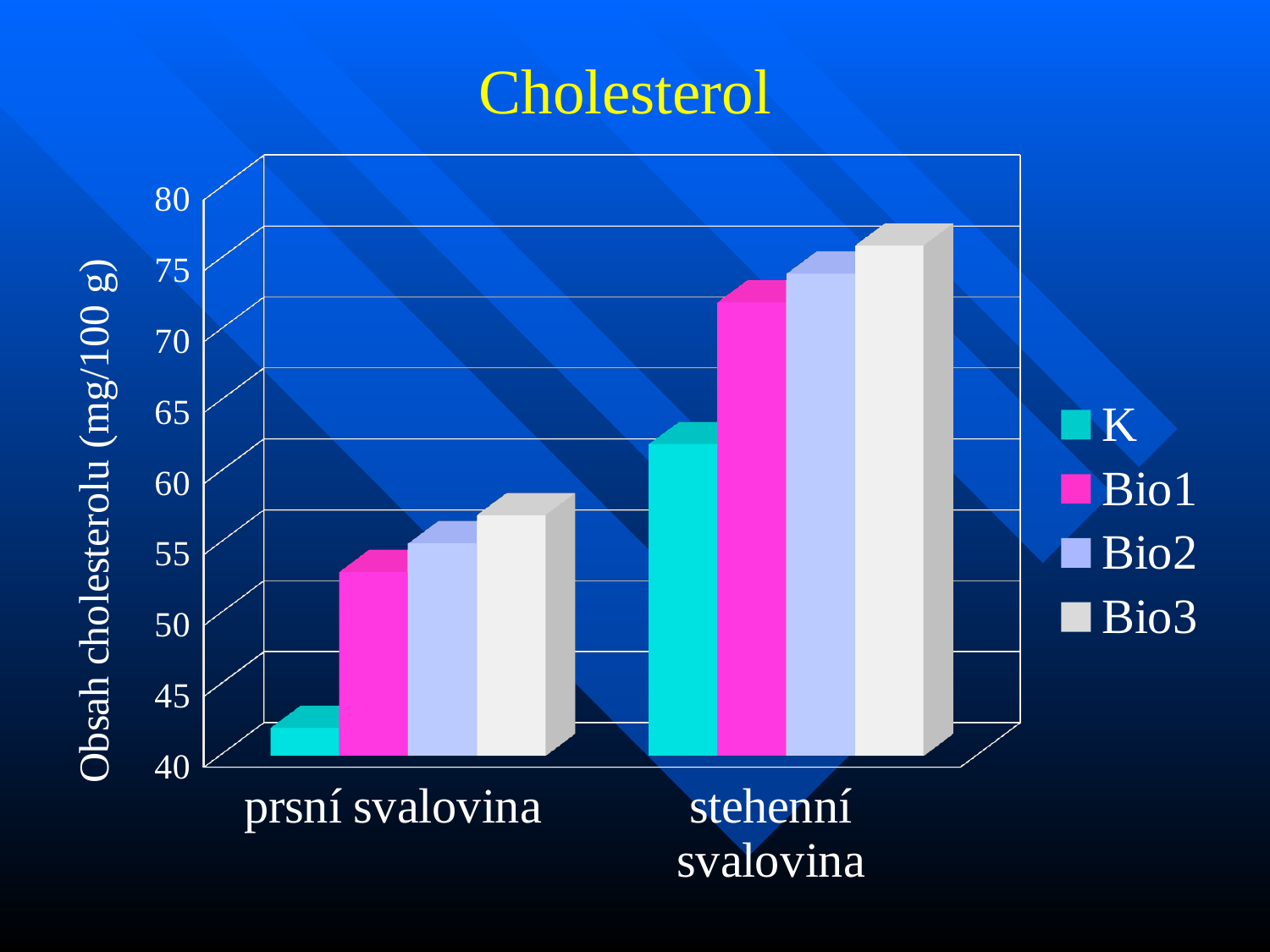
Which is larger: the value for K in prsní svalovina or the value for K in stehenní svalovina? stehenní svalovina Which series has the lowest value for prsní svalovina? K How many series does the legend list? 4 What is the label of the vertical axis? Obsah cholesterolu (mg/100 g) Is the value for Bio1 in stehenní svalovina greater or less than 70? greater Is the value for K in prsní svalovina greater or less than 45? less Is the value for Bio1 in prsní svalovina greater or less than 50? greater What is the title of the chart? Cholesterol Which series has the highest value for stehenní svalovina? Bio3 How many categories are shown on the x axis? 2 What type of chart is shown on the slide? bar chart